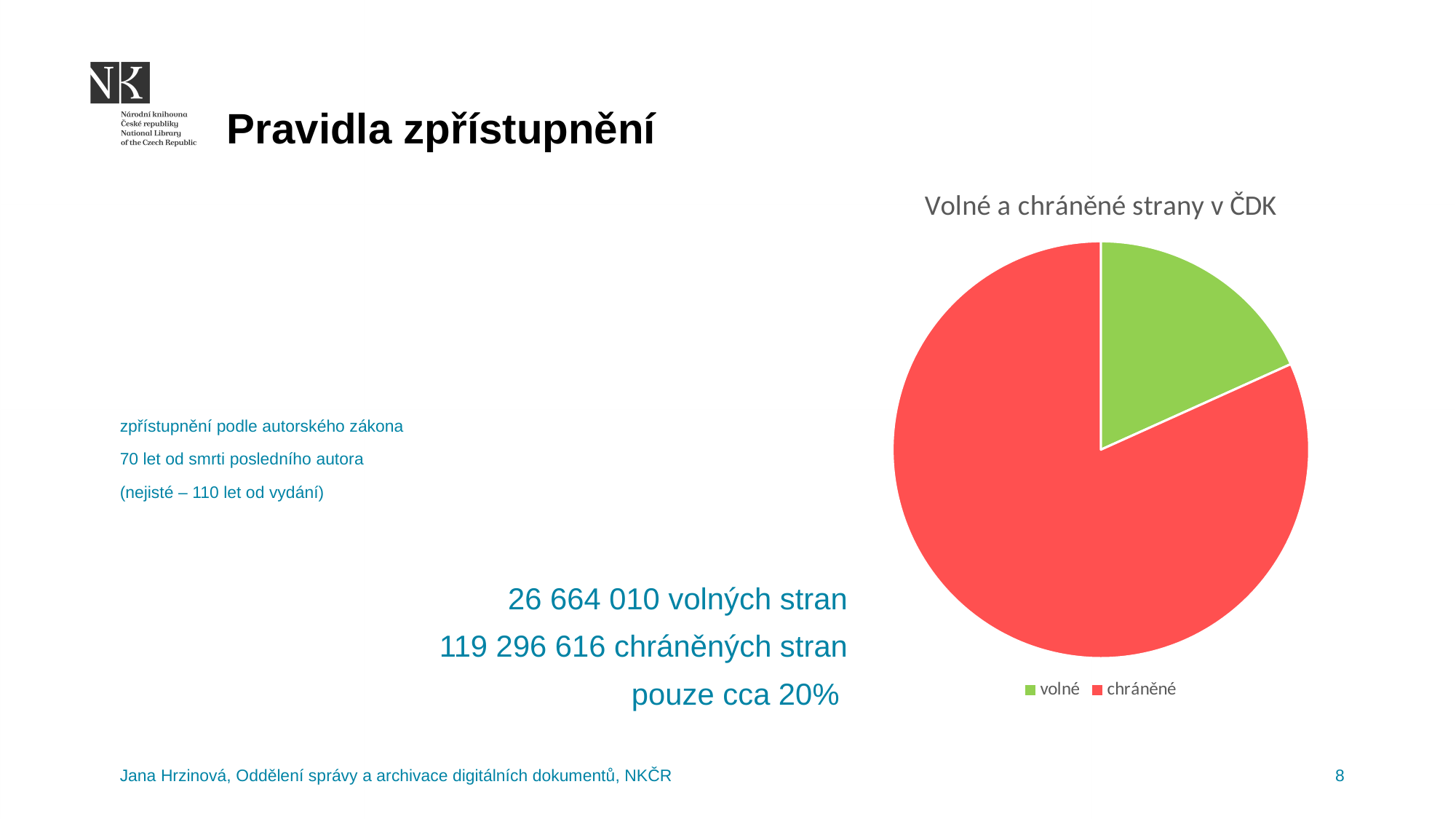
Which category has the smallest slice of the pie? volné What kind of chart is shown on the slide? pie chart How many slices does the pie chart have? 2 What is the title of the chart? Volné a chráněné strany v ČDK What colour is the slice for chráněné? red According to the slide, how many pages are chráněné (protected)? 119 296 616 Which category has the largest slice of the pie? chráněné Which slice is larger, volné or chráněné? chráněné How many entries does the chart legend list? 2 According to the slide, how many pages are volné (free)? 26 664 010